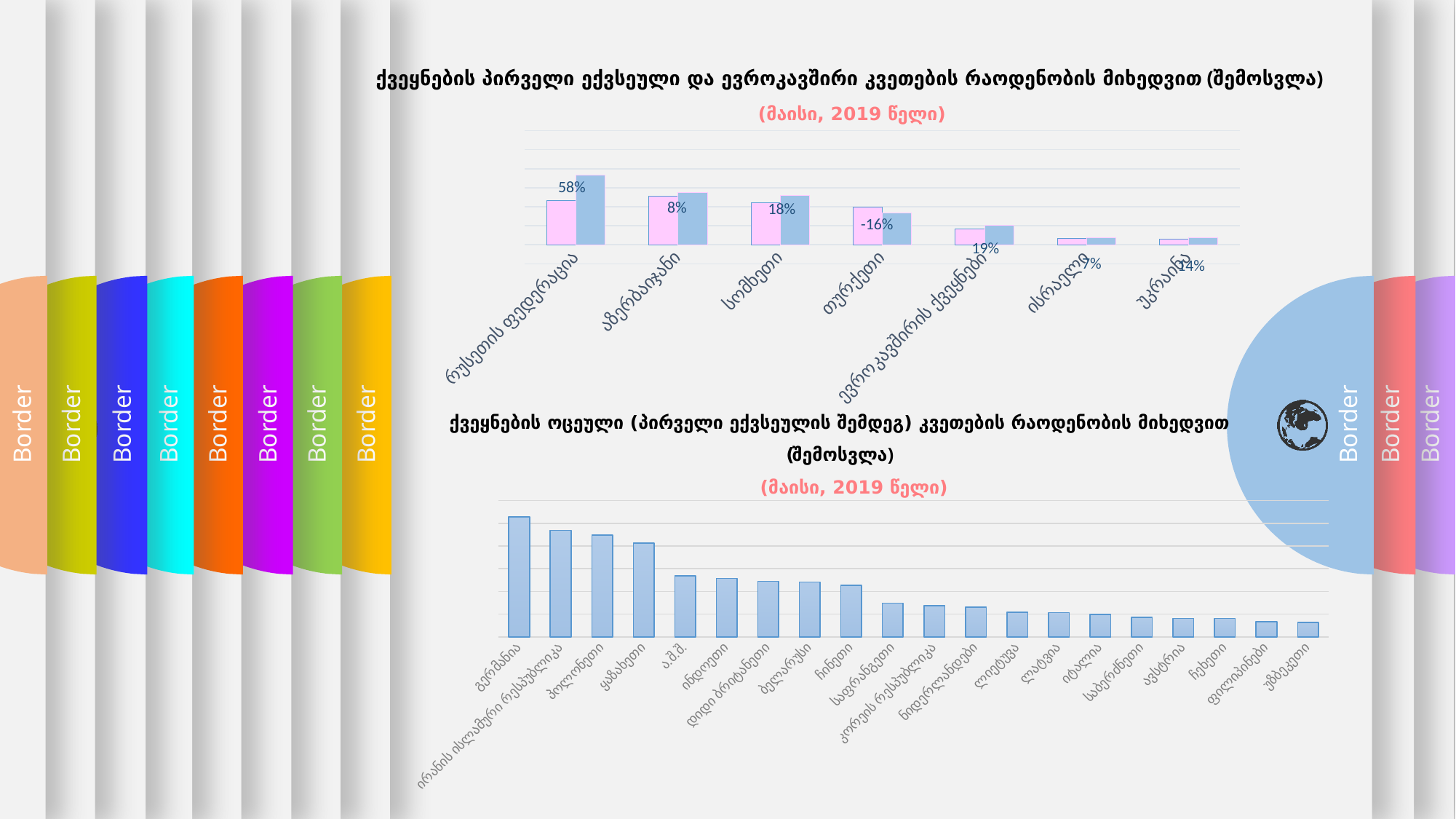
On the top chart, what percentage label is shown for რუსეთის ფედერაცია? 58% On the top chart, how many categories are shown on the x axis? 7 On the top chart, what percentage label is shown for სომხეთი? 18% On the bottom chart, which country has the tallest bar? გერმანია On the bottom chart, which country has the shortest bar? უზბეკეთი On the bottom chart, how many countries are shown on the x axis? 20 On the top chart, what percentage label is shown for ევროკავშირის ქვეყნები? 19% On the top chart, what percentage label is shown for თურქეთი? -16% On the top chart, what percentage label is shown for აზერბაიჯანი? 8% On the top chart, which category has the tallest bars? რუსეთის ფედერაცია What kind of chart is the bottom chart? bar chart On the top chart, which category has the only negative percentage label? თურქეთი